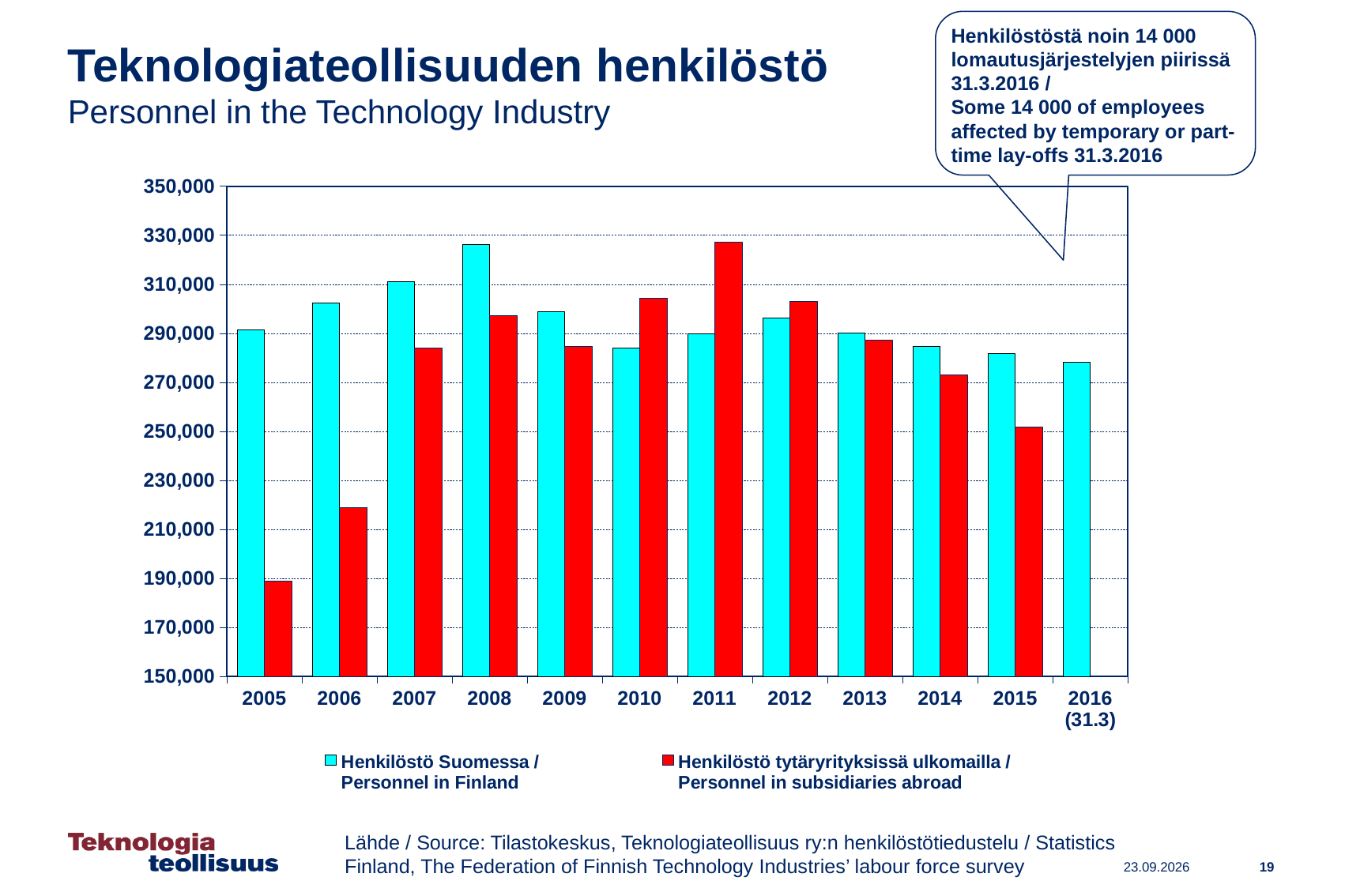
Does Personnel in Finland rise or fall from 2012 to 2016 (31.3)? fall How many year categories are shown on the x axis? 12 In which year is Personnel in subsidiaries abroad highest? 2011 In which year is Personnel in subsidiaries abroad lowest? 2005 Is the value for Personnel in subsidiaries abroad in 2015 greater or less than 270,000? less In which year is Personnel in Finland highest? 2008 Is the value for Personnel in Finland in 2008 greater or less than 310,000? greater What kind of chart is shown on the slide? bar chart In 2011, which is larger: Personnel in Finland or Personnel in subsidiaries abroad? Personnel in subsidiaries abroad Is the value for Personnel in subsidiaries abroad in 2006 greater or less than 230,000? less How many series does the legend list? 2 In 2005, which is larger: Personnel in Finland or Personnel in subsidiaries abroad? Personnel in Finland